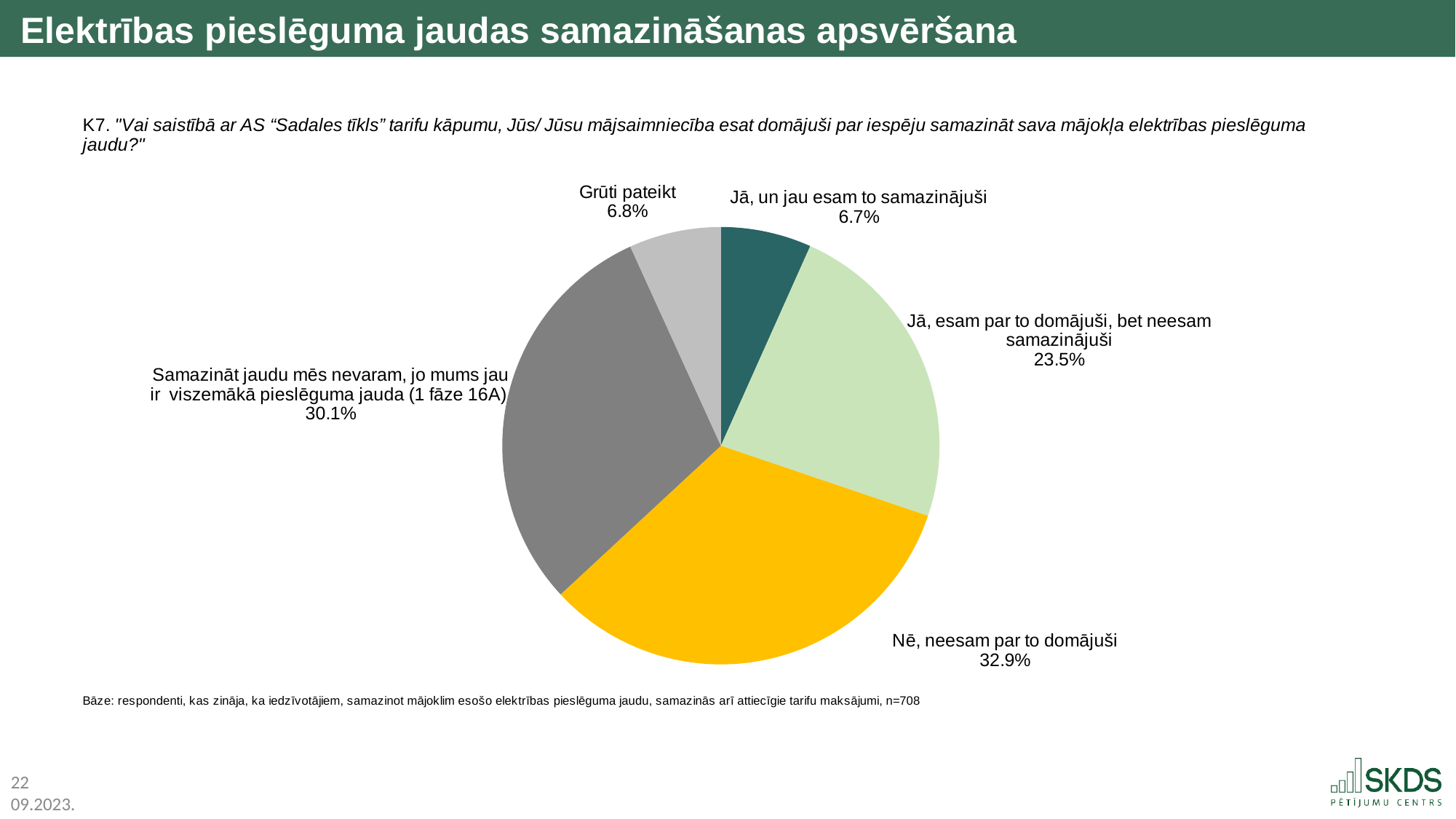
What is the combined share of the two "Jā" answers (6.7% and 23.5%)? 30.2% What percentage is shown for "Jā, un jau esam to samazinājuši"? 6.7% What is the sample size (n) stated in the base note below the chart? n=708 What percentage is shown for "Jā, esam par to domājuši, bet neesam samazinājuši"? 23.5% What is the difference in percentage points between "Nē, neesam par to domājuši" (32.9%) and "Samazināt jaudu mēs nevaram, jo mums jau ir viszemākā pieslēguma jauda (1 fāze 16A)" (30.1%)? 2.8 percentage points What share of the pie is "Grūti pateikt"? 6.8% Which is larger: the share for "Nē, neesam par to domājuši" or the share for "Jā, esam par to domājuši, bet neesam samazinājuši"? Nē, neesam par to domājuši Which answer category has the largest share of the pie? Nē, neesam par to domājuši What type of chart is shown on the slide? Pie chart How many slices does the pie chart have? 5 What percentage of respondents said "Samazināt jaudu mēs nevaram, jo mums jau ir viszemākā pieslēguma jauda (1 fāze 16A)"? 30.1% What share of respondents answered "Nē, neesam par to domājuši"? 32.9%